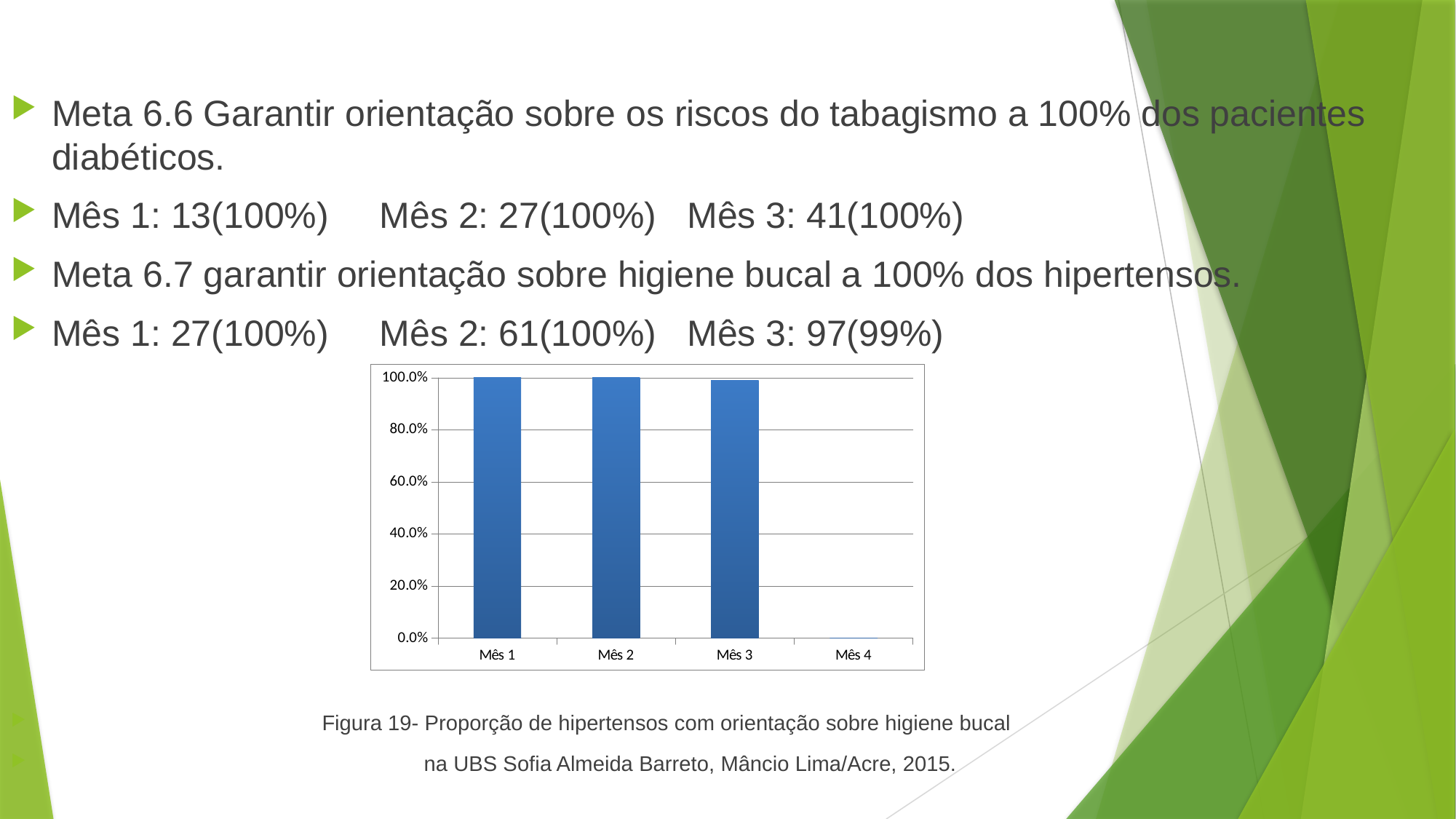
What is the value for Mês 2 in the chart? 100.0% What is the highest tick value shown on the y axis of the chart? 100.0% Is the value for Mês 4 greater or less than 20.0%? less Which category has the lowest value in the chart? Mês 4 Which is larger, the value for Mês 2 or the value for Mês 3? Mês 2 What kind of chart is shown on the slide? bar chart Which is larger, the value for Mês 1 or the value for Mês 4? Mês 1 How many categories are shown on the x axis of the chart? 4 Is the value for Mês 3 greater or less than 80.0%? greater What colour are the bars in the chart? blue What is the value for Mês 1 in the chart? 100.0%